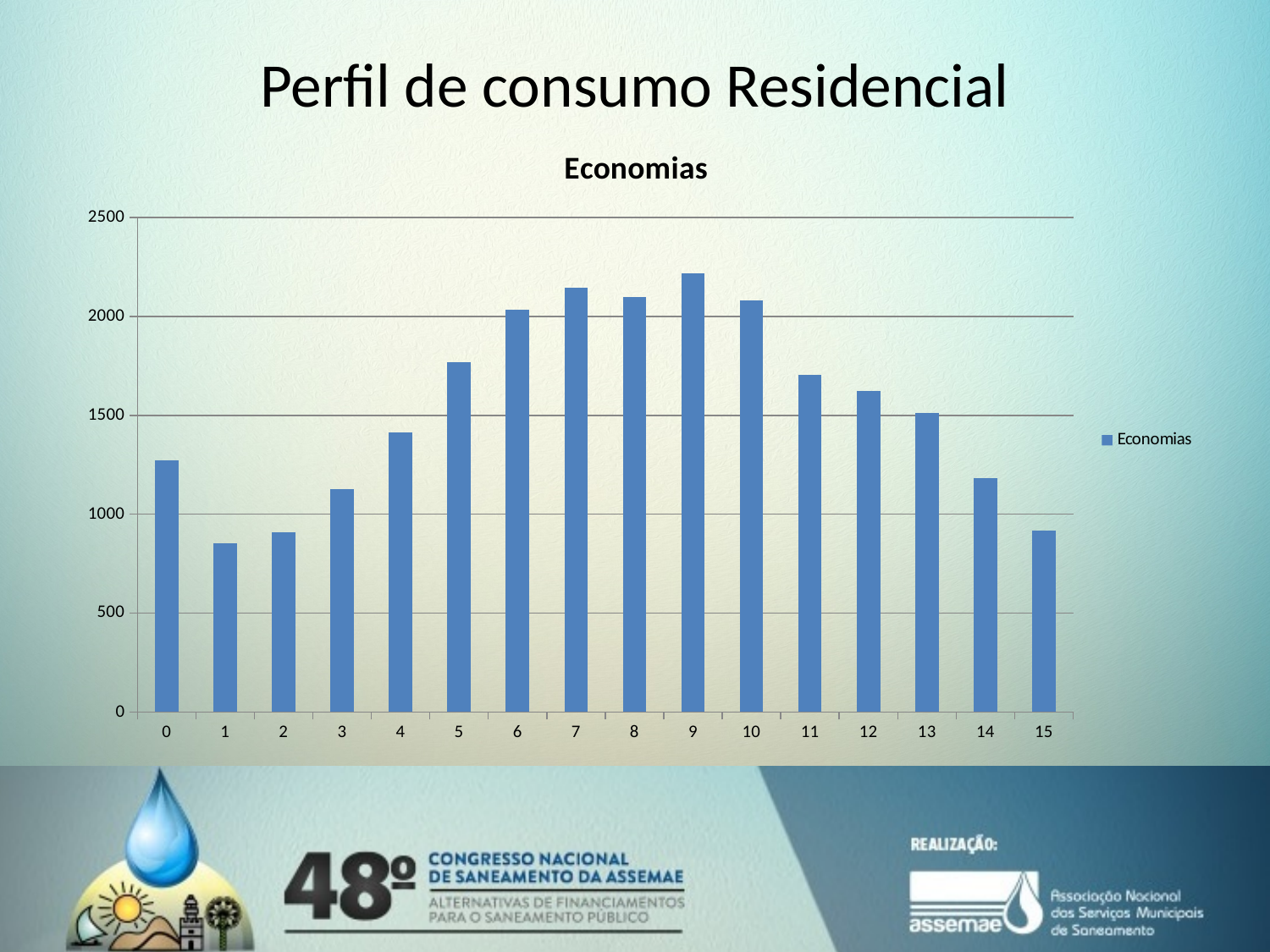
Is the value for category 0 greater or less than 1000? greater What kind of chart is shown on the slide? bar chart Is the value for category 6 greater or less than 2000? greater Do the values rise or fall from category 9 to category 15? fall How many categories are shown on the x axis? 16 How many series does the legend list? 1 Is the value for category 14 greater or less than 1500? less Which has the larger value, category 4 or category 13? 13 Which category has the highest value? 9 What is the title of the chart? Economias